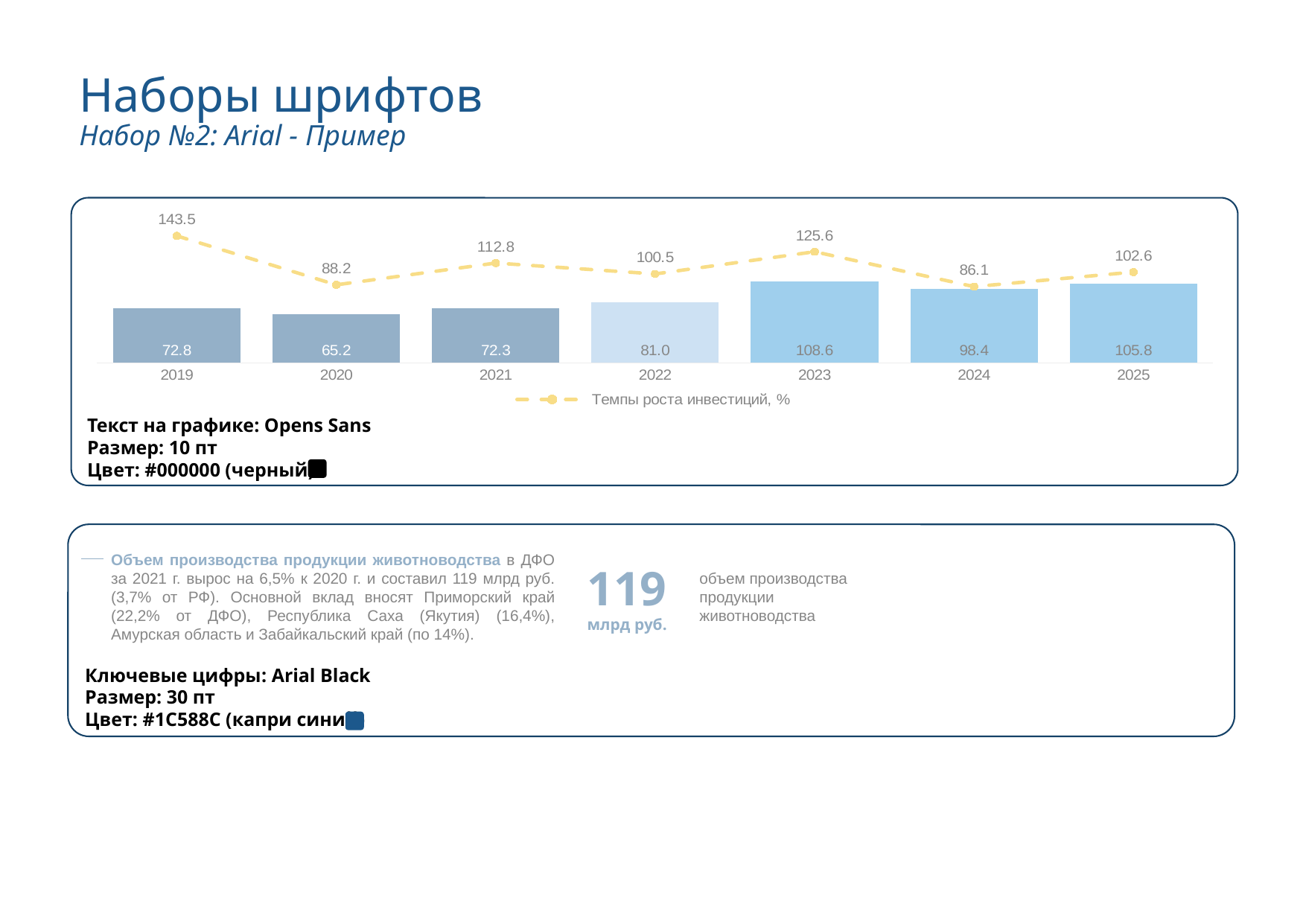
Which year has the lowest value on the 'Темпы роста инвестиций, %' line? 2024 Which year has the lowest bar value? 2020 What is the bar value for 2020? 65.2 How many years are shown on the x axis of the chart? 7 Which year has the highest bar value? 2023 What is the bar value for 2023? 108.6 What is the legend entry for the dashed line in the chart? Темпы роста инвестиций, % What is the difference between the bar values for 2023 and 2022? 27.6 What is the value of the 'Темпы роста инвестиций, %' line for 2019? 143.5 What is the value of the 'Темпы роста инвестиций, %' line for 2024? 86.1 How many series does the chart legend list? 1 Which is larger, the bar value for 2024 or the bar value for 2025? 2025